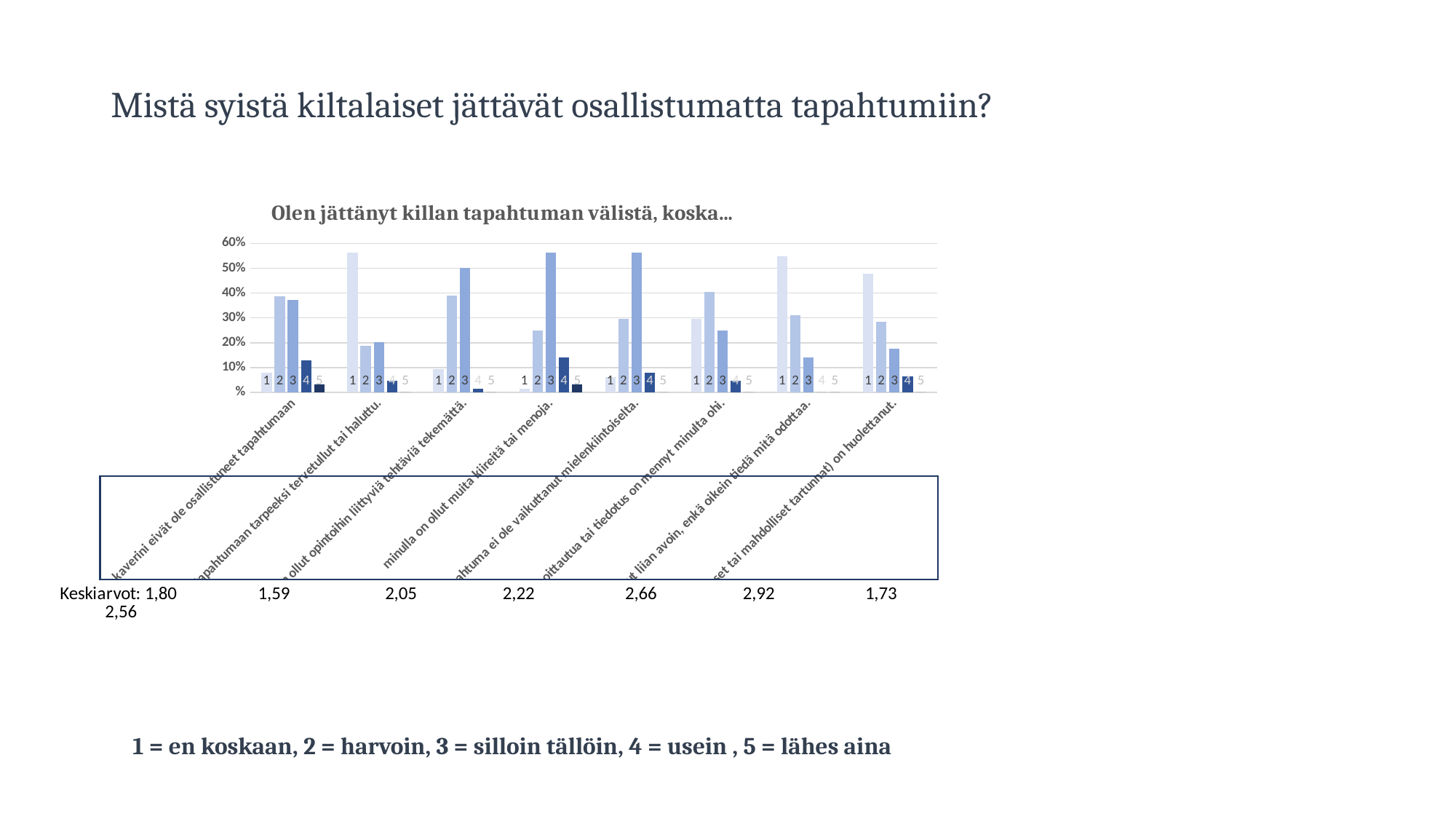
How many bars (response options 1–5) are plotted for each category? 5 For the category ending 'liian avoin, enkä oikein tiedä mitä odottaa.', which response option (1–5) has the highest bar? 1 For the category 'kaverini eivät ole osallistuneet tapahtumaan', is the value for response 1 greater or less than 10%? less For the category 'kaverini eivät ole osallistuneet tapahtumaan', which is larger: the bar for response 1 or the bar for response 2? 2 For the category 'minulla on ollut muita kiireitä tai menoja.', is the value for response 3 greater or less than 50%? greater What is the highest value shown on the y axis of the chart? 60% For the category 'minulla on ollut muita kiireitä tai menoja.', which response option (1–5) has the highest bar? 3 For the category ending 'tarpeeksi tervetullut tai haluttu.', is the value for response 1 greater or less than 50%? greater For the category ending 'ei ole vaikuttanut mielenkiintoiselta.', which is larger: the bar for response 2 or the bar for response 3? 3 What is the title of the chart? Olen jättänyt killan tapahtuman välistä, koska... How many categories (reasons) are shown along the x axis of the chart? 8 What kind of chart is shown on the slide? bar chart